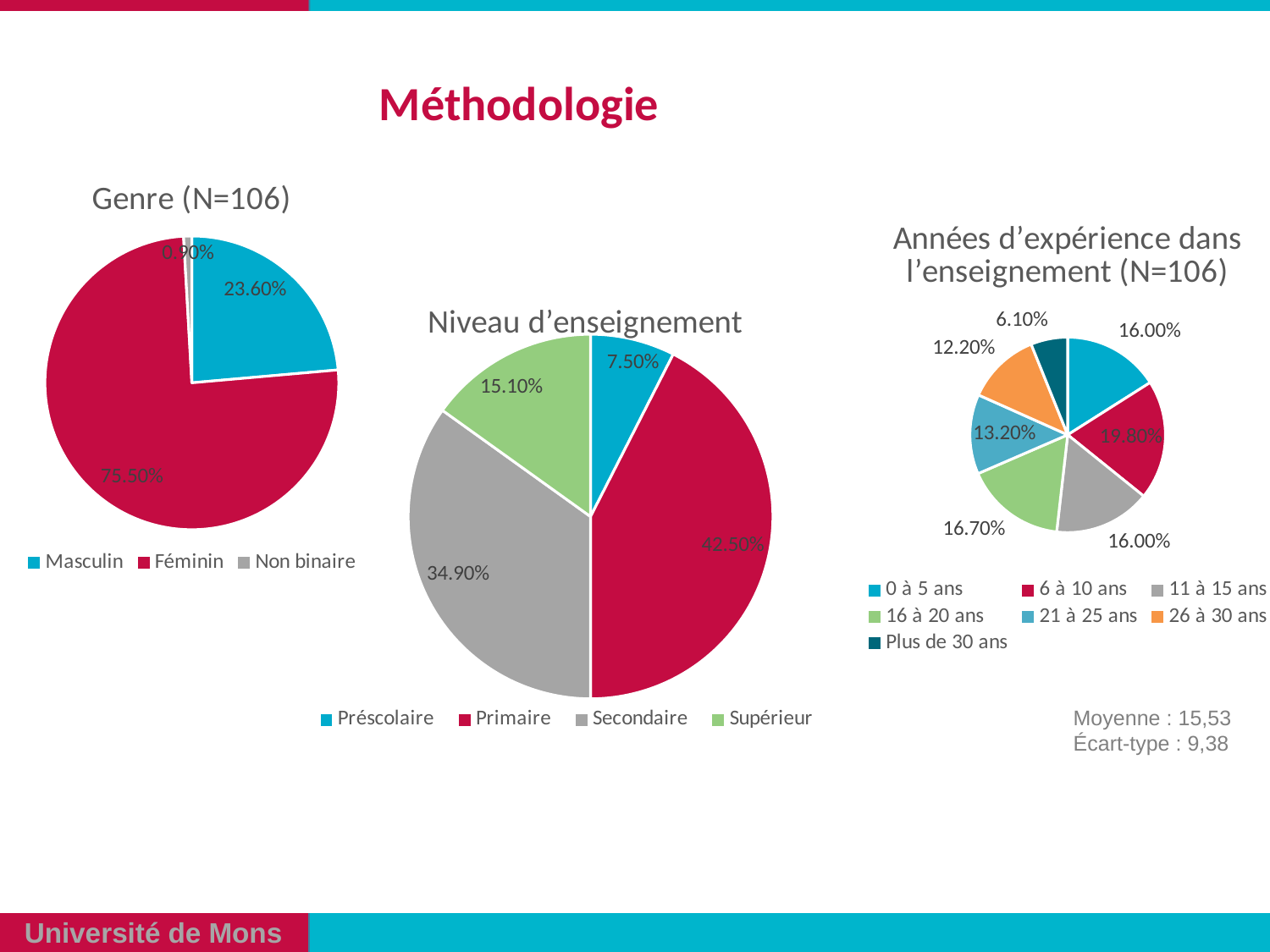
In the 'Années d'expérience dans l'enseignement (N=106)' chart, which is larger: 16 à 20 ans or 21 à 25 ans? 16 à 20 ans In the 'Niveau d'enseignement' chart, what is the difference between the Primaire and Secondaire shares? 7.60% In the 'Genre (N=106)' chart, which category has the smallest slice? Non binaire How many categories does the legend of the 'Niveau d'enseignement' chart list? 4 What kind of chart is 'Niveau d'enseignement'? Pie chart In the 'Genre (N=106)' chart, what share is Masculin? 23.60% In the 'Années d'expérience dans l'enseignement (N=106)' chart, which category has the smallest slice? Plus de 30 ans In the 'Niveau d'enseignement' chart, which category has the largest slice? Primaire In the 'Niveau d'enseignement' chart, what share is Secondaire? 34.90% How many categories does the legend of the 'Années d'expérience dans l'enseignement (N=106)' chart list? 7 In the 'Genre (N=106)' chart, what share is Féminin? 75.50%